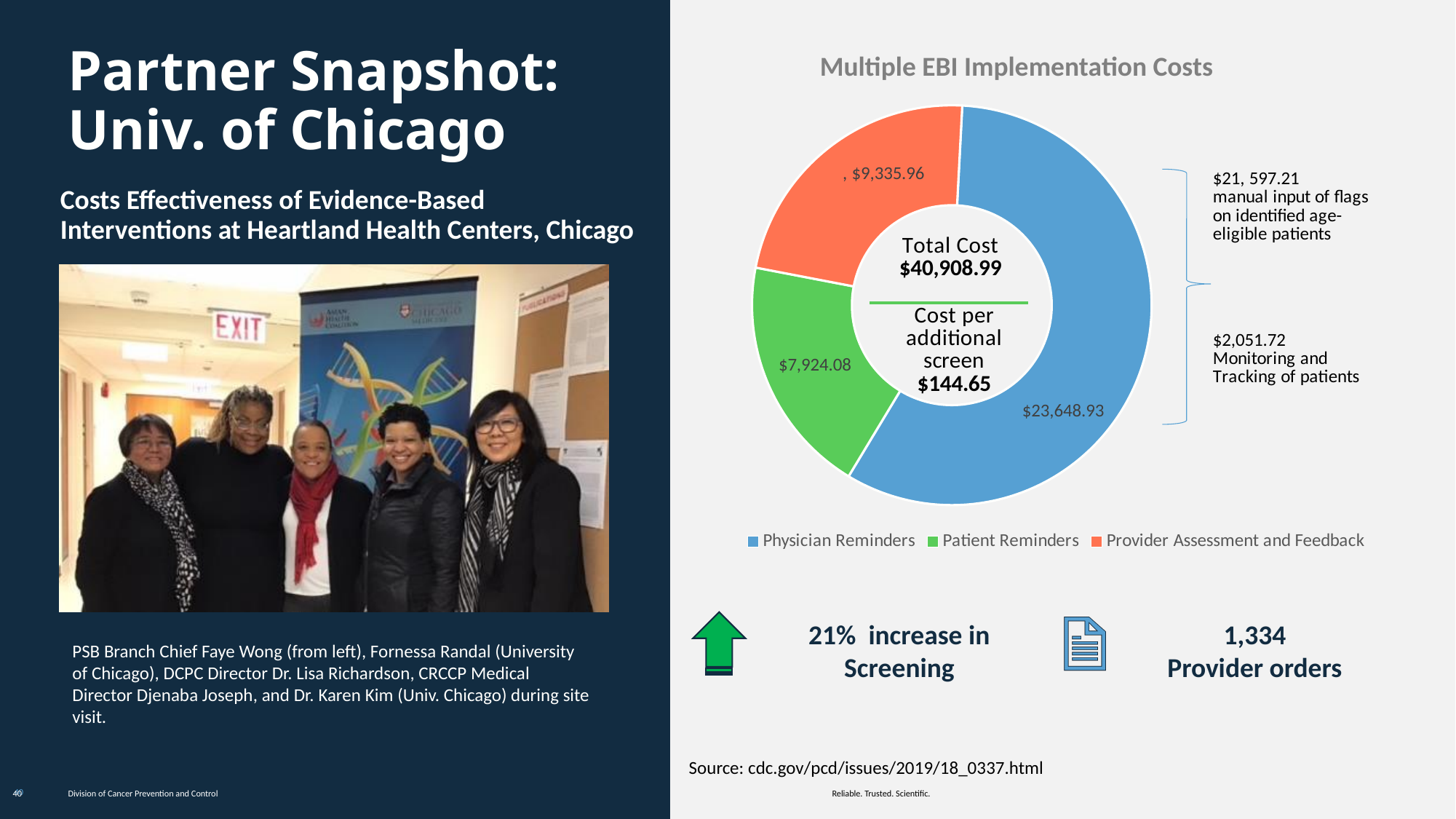
What is the title of the chart on the slide? Multiple EBI Implementation Costs What Total Cost is shown in the centre of the chart? $40,908.99 How many series does the legend of the Multiple EBI Implementation Costs chart list? 3 Which is larger, the cost for Provider Assessment and Feedback or the cost for Patient Reminders? Provider Assessment and Feedback What is the cost shown for Physician Reminders? $23,648.93 What is the cost shown for Patient Reminders? $7,924.08 Which category has the lowest implementation cost? Patient Reminders What kind of chart is used to show the Multiple EBI Implementation Costs? doughnut chart What is the difference between the Physician Reminders cost and the Provider Assessment and Feedback cost? $14,312.97 What is the Cost per additional screen shown in the centre of the chart? $144.65 Which category has the highest implementation cost? Physician Reminders What is the cost shown for Provider Assessment and Feedback? $9,335.96